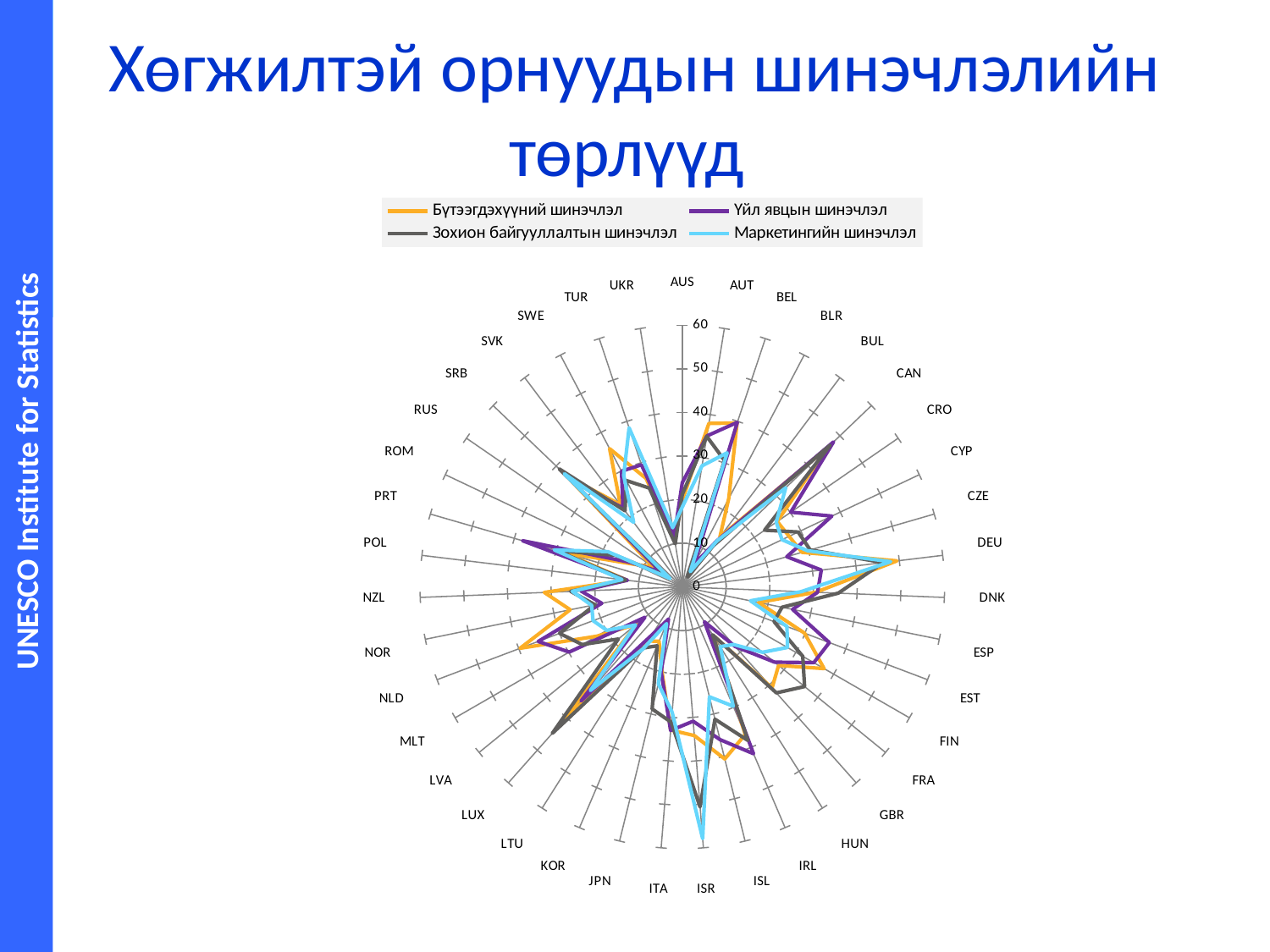
Is the value of Үйл явцын шинэчлэл for POL greater or less than 30? less Is the value of Бүтээгдэхүүний шинэчлэл for DEU greater or less than 40? greater Which series has the highest value for ISR? Маркетингийн шинэчлэл Which series is shown in light blue according to the legend? Маркетингийн шинэчлэл What is the highest value shown on the chart's radial axis? 60 Is the value of Үйл явцын шинэчлэл for POL greater or less than 50? less How many series does the legend list? 4 How many country categories are plotted around the chart? 39 What kind of chart is shown on the slide? radar chart For ISR, which is larger: the value of Маркетингийн шинэчлэл or the value of Зохион байгууллалтын шинэчлэл? Маркетингийн шинэчлэл